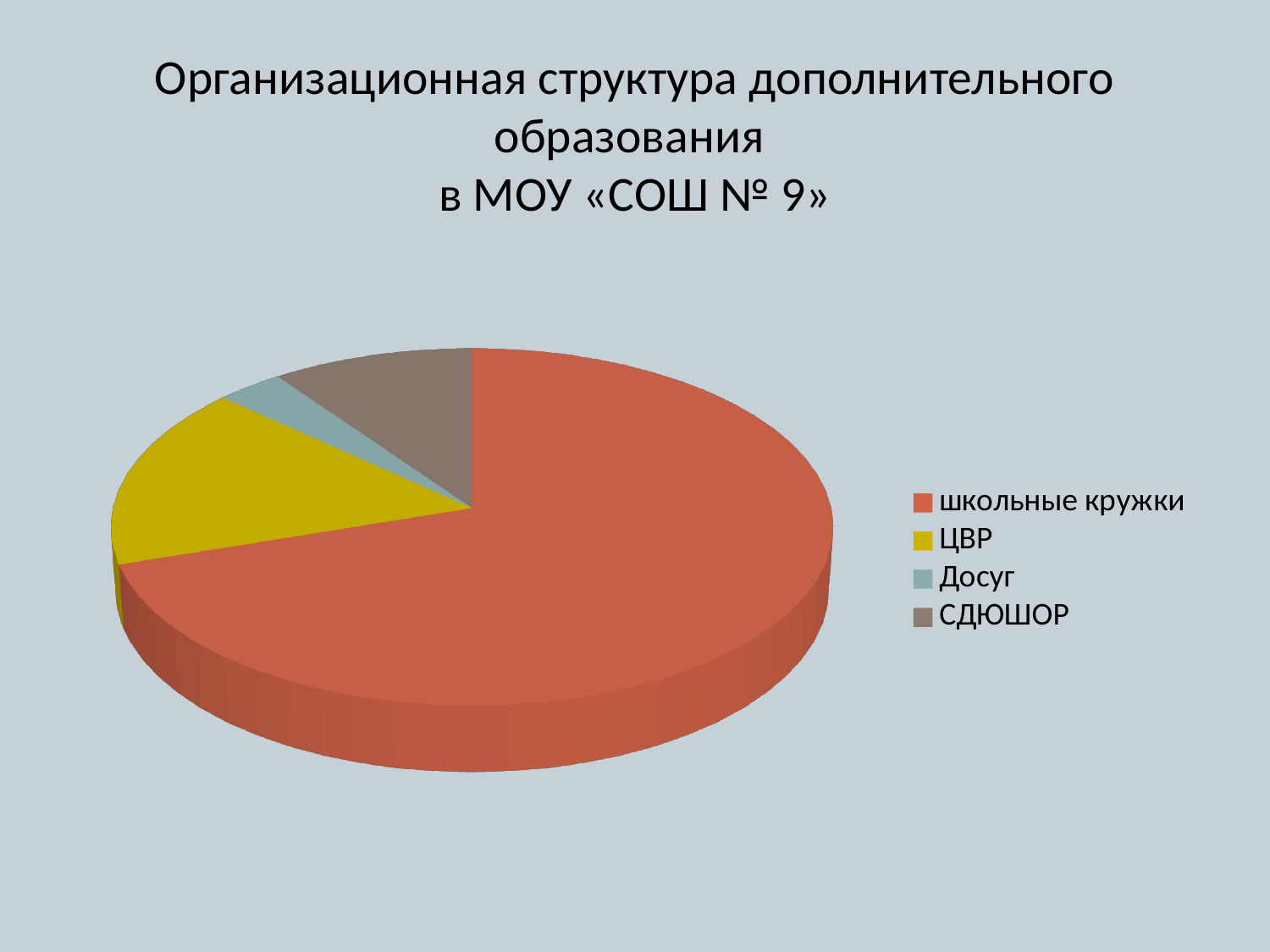
Which category has the smallest slice of the pie? Досуг What is the title of the slide? Организационная структура дополнительного образования в МОУ «СОШ № 9» How many entries does the legend list? 4 Which slice is larger, СДЮШОР or Досуг? СДЮШОР What kind of chart is shown on the slide? pie chart What colour is the slice for ЦВР? yellow Which category has the largest slice of the pie? школьные кружки Which slice is larger, ЦВР or Досуг? ЦВР Which slice is larger, школьные кружки or ЦВР? школьные кружки How many categories does the pie chart show? 4